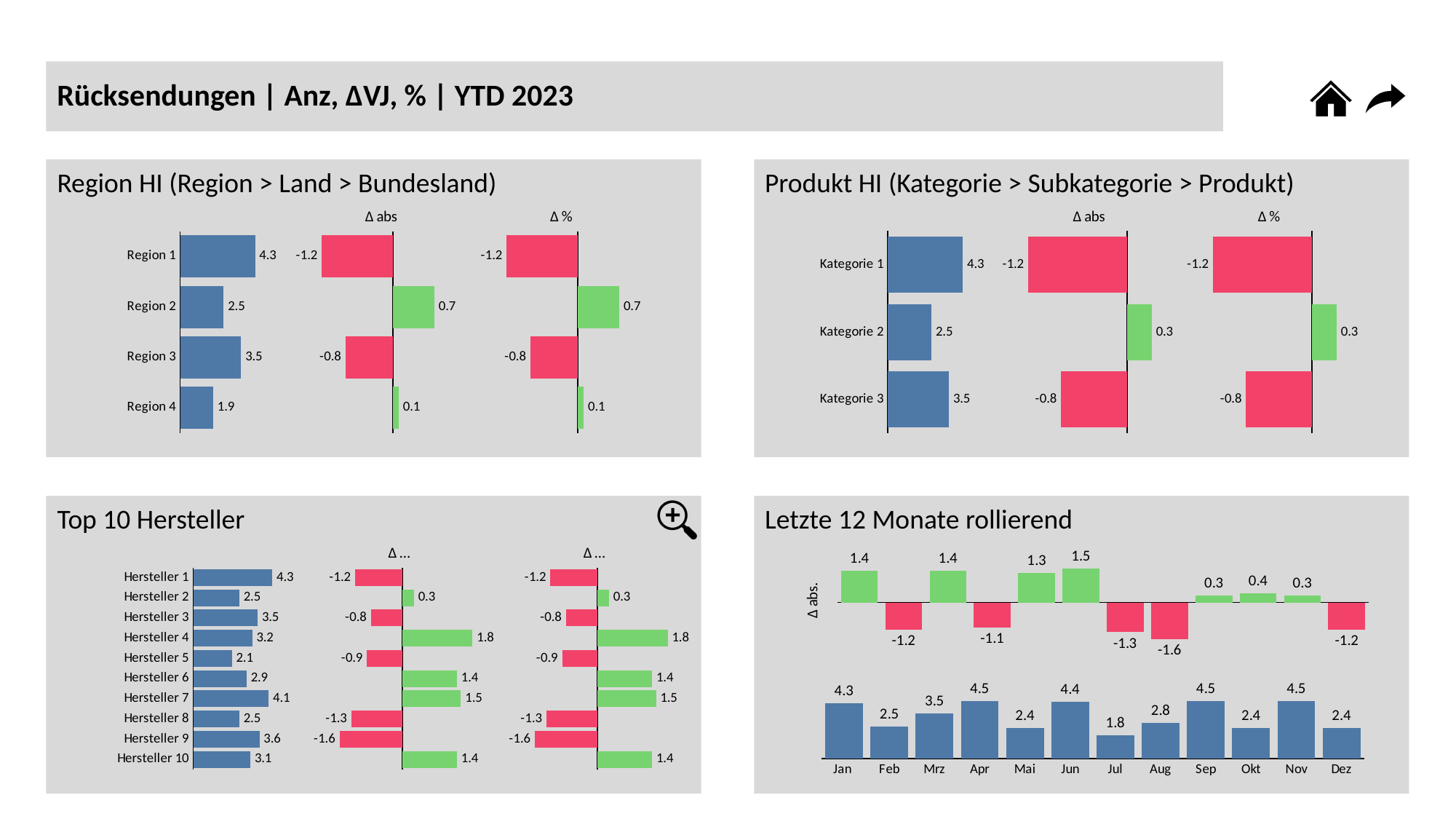
In the 'Region HI' chart, which region has the lowest value? Region 4 In the 'Region HI' chart, what is the value for Region 3? 3.5 In the 'Region HI' chart, what is the Δ abs value for Region 2? 0.7 In the 'Top 10 Hersteller' chart, what is the difference between the values for Hersteller 9 and Hersteller 5? 1.5 In the 'Top 10 Hersteller' chart, what is the value for Hersteller 7? 4.1 In the 'Letzte 12 Monate rollierend' chart, which month has the lowest Δ abs. value? Aug In the 'Letzte 12 Monate rollierend' chart, is the value for Apr or Mai larger in the lower bar chart? Apr In the 'Top 10 Hersteller' chart, which Hersteller has the highest value? Hersteller 1 In the 'Letzte 12 Monate rollierend' chart, what is the value for Jul in the lower bar chart? 1.8 In the 'Produkt HI' chart, what is the Δ % value for Kategorie 3? -0.8 In the 'Produkt HI' chart, how many categories are shown? 3 What kind of chart is used in the 'Letzte 12 Monate rollierend' panel? Bar chart